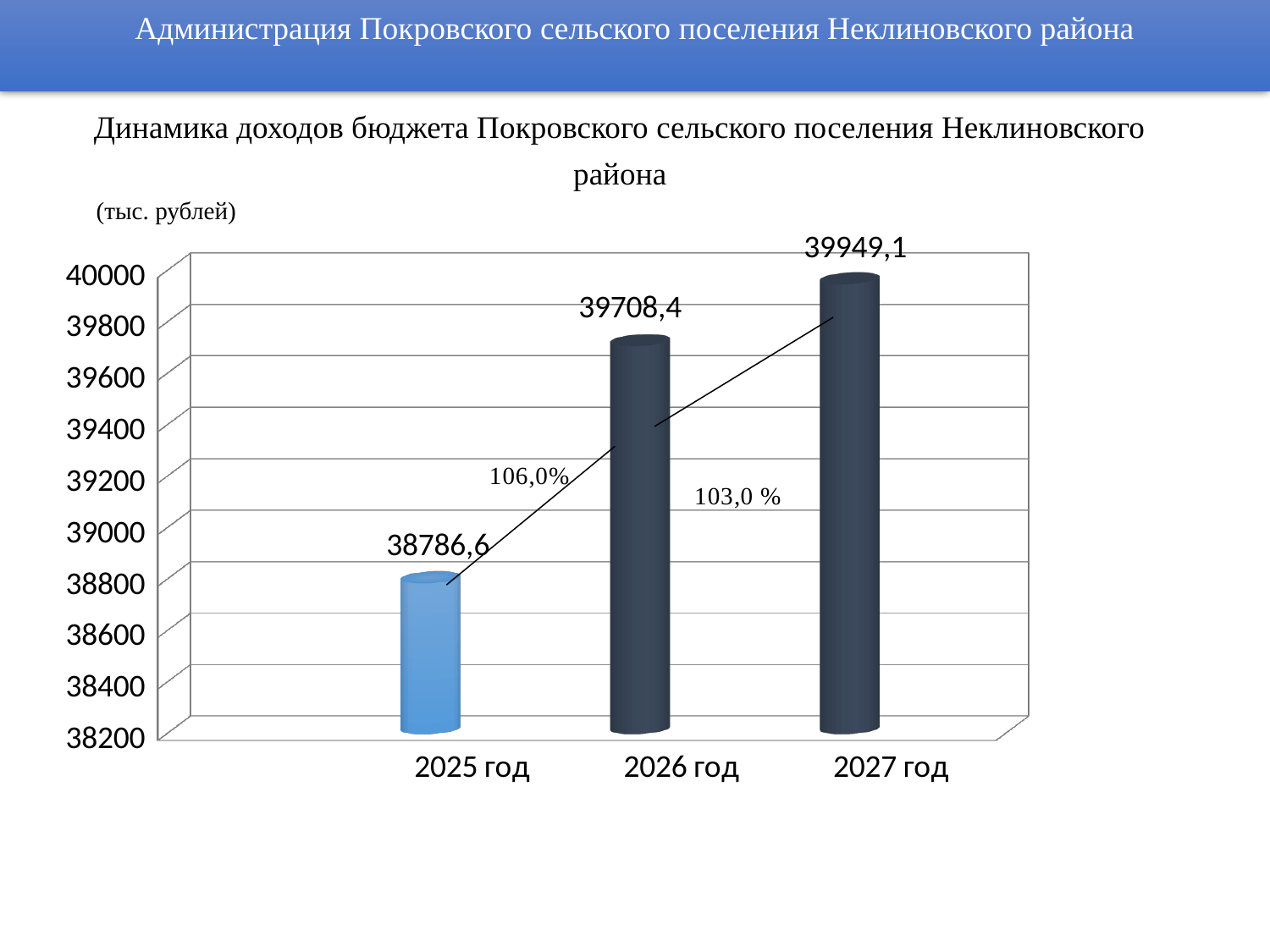
What is the budget revenue value shown for 2026 год? 39708,4 What is the difference between the values for 2026 год and 2025 год? 921,8 What is the budget revenue value shown for 2025 год? 38786,6 Which year has the lowest budget revenue on the chart? 2025 год How many years (categories) are plotted on the chart? 3 Which is larger, the value for 2026 год or the value for 2027 год? 2027 год What is the difference between the values for 2027 год and 2026 год? 240,7 Is the value for 2025 год greater or less than 39000? less Which year has the highest budget revenue on the chart? 2027 год Do the budget revenue values rise or fall from 2025 год to 2027 год? rise What is the budget revenue value shown for 2027 год? 39949,1 What kind of chart is shown on the slide? bar chart